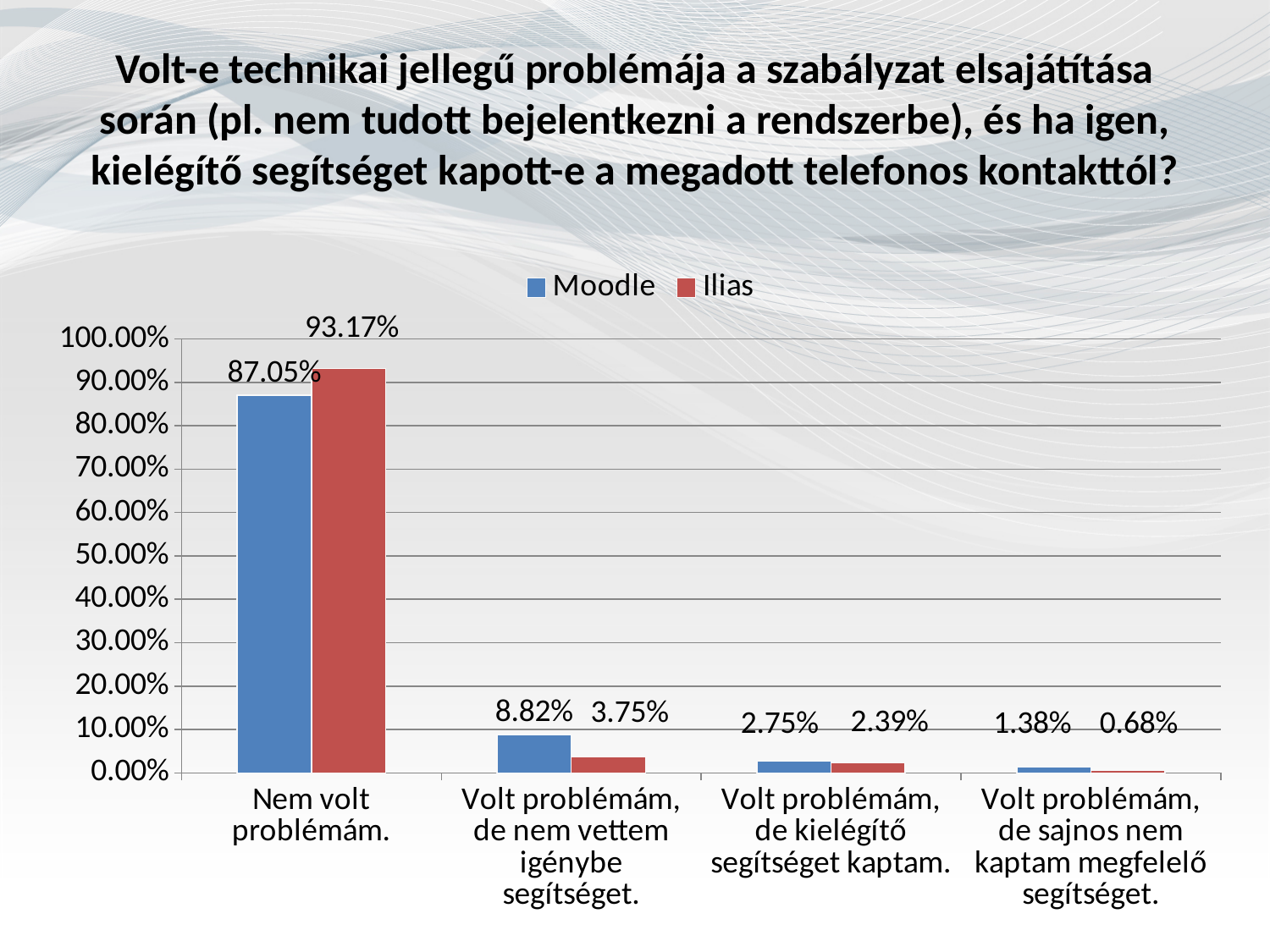
Which category has the lowest Moodle value? Volt problémám, de sajnos nem kaptam megfelelő segítséget. What is the Ilias value for "Nem volt problémám."? 93.17% Which category has the highest Ilias value? Nem volt problémám. How many categories are shown on the x axis? 4 What is the difference between the Ilias and Moodle values for "Nem volt problémám."? 6.12% What is the Moodle value for "Volt problémám, de nem vettem igénybe segítséget."? 8.82% What kind of chart is shown on the slide? Bar chart For "Volt problémám, de nem vettem igénybe segítséget.", which series has the larger value, Moodle or Ilias? Moodle What is the Ilias value for "Volt problémám, de sajnos nem kaptam megfelelő segítséget."? 0.68% What is the Moodle value for "Nem volt problémám."? 87.05% How many series does the legend list? 2 What is the difference between the Moodle and Ilias values for "Volt problémám, de nem vettem igénybe segítséget."? 5.07%